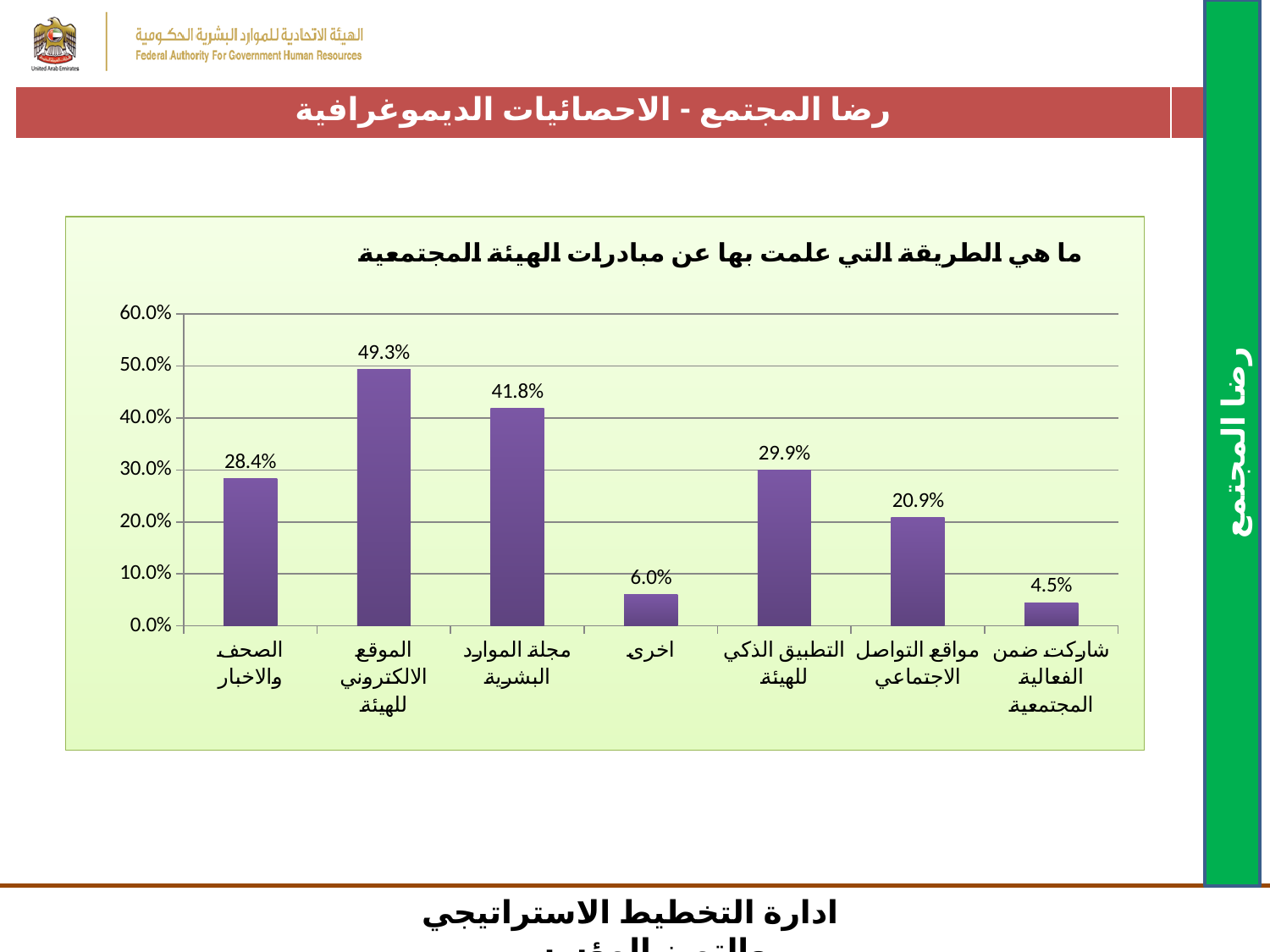
Which is larger, the value for الصحف والاخبار or the value for التطبيق الذكي للهيئة? التطبيق الذكي للهيئة Which category has the highest value? الموقع الالكتروني للهيئة Is the value for التطبيق الذكي للهيئة greater or less than 20.0%? greater What value is shown for مجلة الموارد البشرية? 41.8% What value is shown for مواقع التواصل الاجتماعي? 20.9% What value is shown for الموقع الالكتروني للهيئة? 49.3% What kind of chart is shown on the slide? bar chart How many categories are shown on the x axis? 7 What is the difference between the values for الموقع الالكتروني للهيئة and مجلة الموارد البشرية? 7.5% What is the title of the chart? ما هي الطريقة التي علمت بها عن مبادرات الهيئة المجتمعية What value is shown for اخرى? 6.0% Which category has the lowest value? شاركت ضمن الفعالية المجتمعية